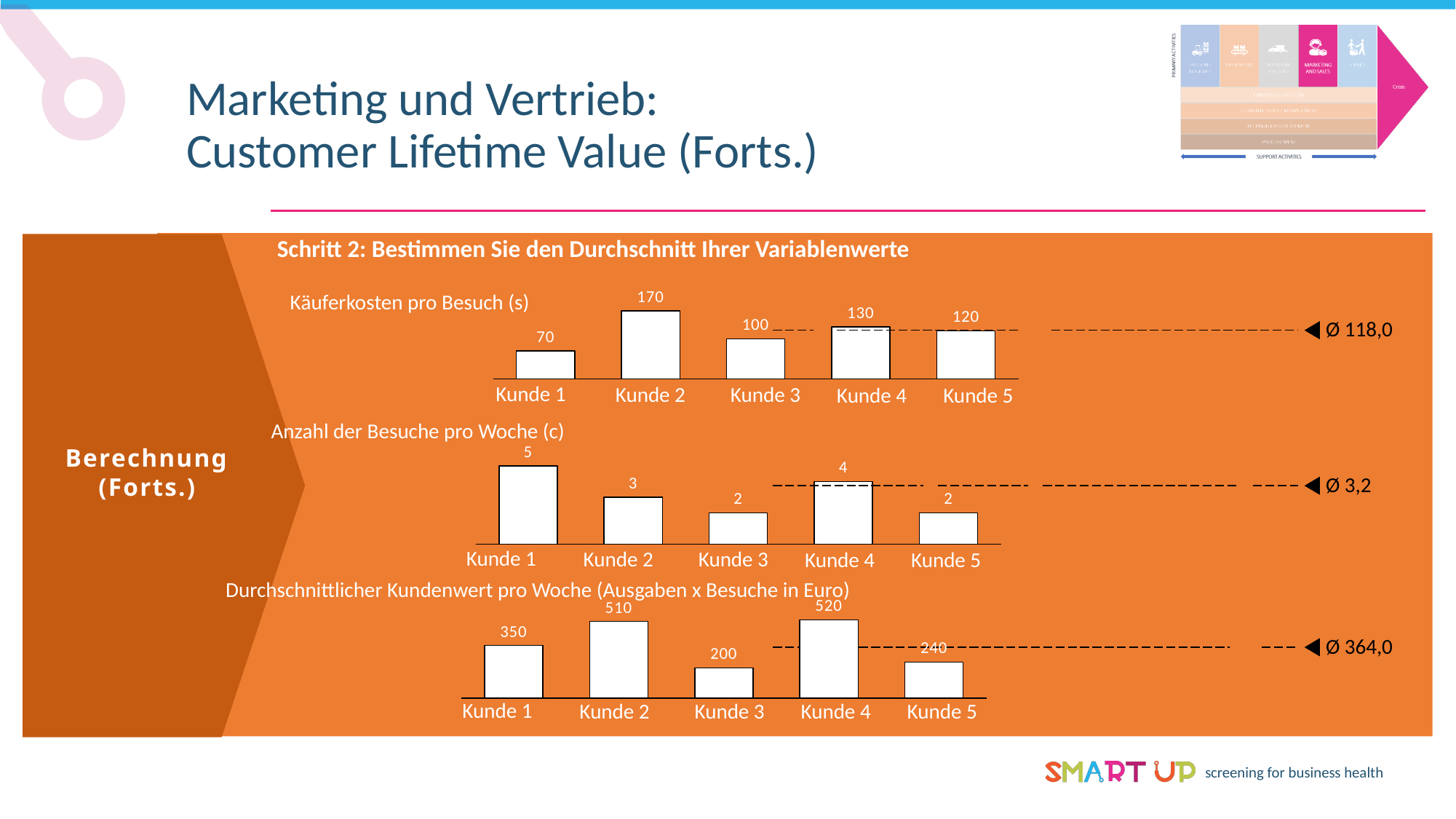
In the 'Käuferkosten pro Besuch (s)' chart, what is the difference between Kunde 4 and Kunde 3? 30 In the 'Durchschnittlicher Kundenwert pro Woche' chart, which customer has the highest value? Kunde 4 In the 'Käuferkosten pro Besuch (s)' chart, what average value is shown at the right of the dashed line? Ø 118,0 In the 'Durchschnittlicher Kundenwert pro Woche' chart, what is the difference between Kunde 1 and Kunde 3? 150 In the 'Anzahl der Besuche pro Woche (c)' chart, how many customers are shown? 5 In the 'Anzahl der Besuche pro Woche (c)' chart, is the value for Kunde 2 or Kunde 4 larger? Kunde 4 What kind of chart is the 'Durchschnittlicher Kundenwert pro Woche' chart? bar chart In the 'Käuferkosten pro Besuch (s)' chart, which customer has the lowest value? Kunde 1 In the 'Käuferkosten pro Besuch (s)' chart, what is the value for Kunde 2? 170 In the 'Anzahl der Besuche pro Woche (c)' chart, what is the value for Kunde 1? 5 In the 'Durchschnittlicher Kundenwert pro Woche' chart, what is the value for Kunde 5? 240 In the 'Anzahl der Besuche pro Woche (c)' chart, which customer has the highest value? Kunde 1